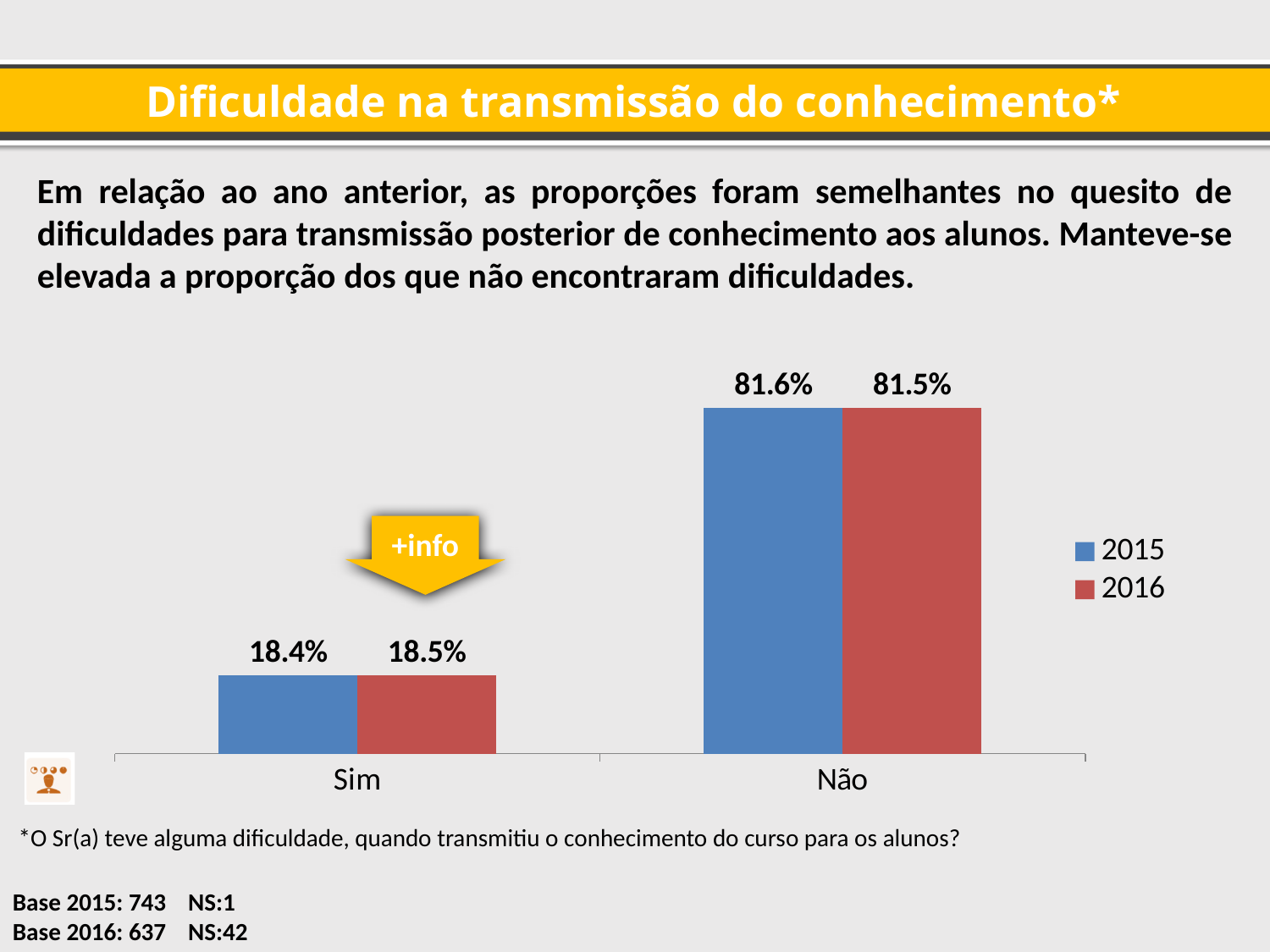
What is the value for 'Não' in the 2015 series? 81.6% Which series is shown in red in the chart legend? 2016 In the 2016 series, which is larger: the value for 'Sim' or the value for 'Não'? Não What kind of chart is shown on the slide? Bar chart What is the value for 'Sim' in the 2015 series? 18.4% Which category has the lowest value in the 2015 series? Sim How many series does the chart legend list? 2 What is the value for 'Não' in the 2016 series? 81.5% Which category has the highest value in the 2016 series? Não How many categories are shown on the x axis of the chart? 2 What is the difference between the 'Não' and 'Sim' values in the 2015 series? 63.2 percentage points What is the value for 'Sim' in the 2016 series? 18.5%